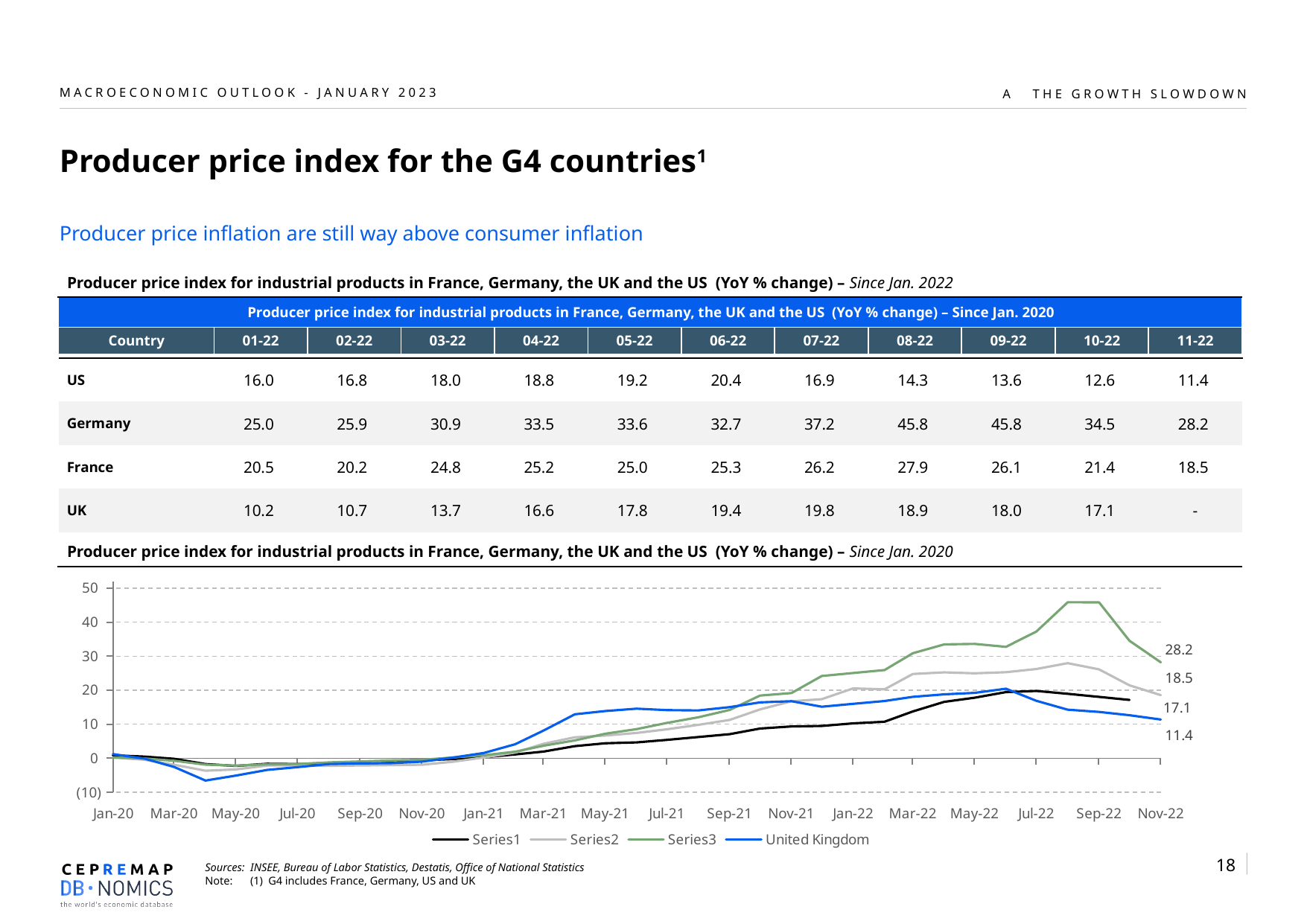
Which series has the lowest end-of-series data label? United Kingdom What is the difference between the end-of-series data labels of Series3 (28.2) and United Kingdom (11.4)? 16.8 What is the data label shown at the end of the green Series3 line in Nov-22? 28.2 What is the highest value shown on the chart's vertical axis? 50 Which series reaches the highest peak value on the chart? Series3 Does the Series3 line rise or fall between Sep-22 and Nov-22? fall What is the data label shown at the end of the grey Series2 line? 18.5 Is the peak value of Series3 in 2022 greater or less than 40? greater What are the four series names listed in the chart legend? Series1, Series2, Series3, United Kingdom What type of chart is shown on the slide? line chart What is the data label shown at the end of the blue United Kingdom line in Nov-22? 11.4 How many series does the chart legend list? 4